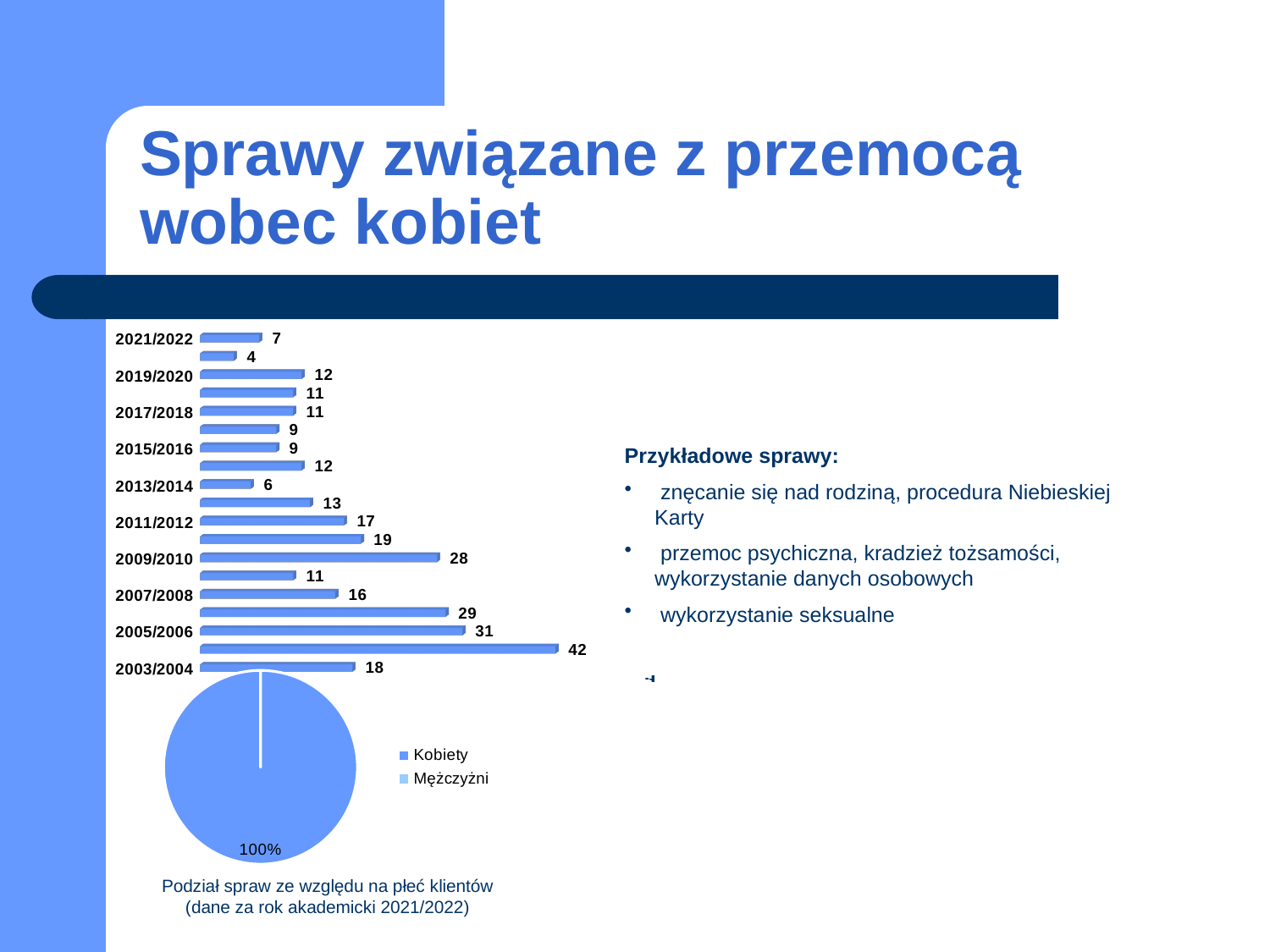
In the bar chart, what is the value for 2013/2014? 6 In the pie chart, what share does Kobiety have? 100% How many entries does the legend of the pie chart list? 2 In the bar chart, which is larger, the value for 2013/2014 or the value for 2015/2016? 2015/2016 In the bar chart, what is the difference between the values for 2005/2006 and 2003/2004? 13 In the bar chart, what is the value for 2009/2010? 28 In the bar chart, how many bars are plotted? 19 What kind of chart is the chart at the top left of the slide? bar chart In the bar chart, what is the value for 2005/2006? 31 In the bar chart, which is larger, the value for 2009/2010 or the value for 2011/2012? 2009/2010 In the bar chart, what is the value for 2021/2022? 7 In the bar chart, what is the value for 2003/2004? 18